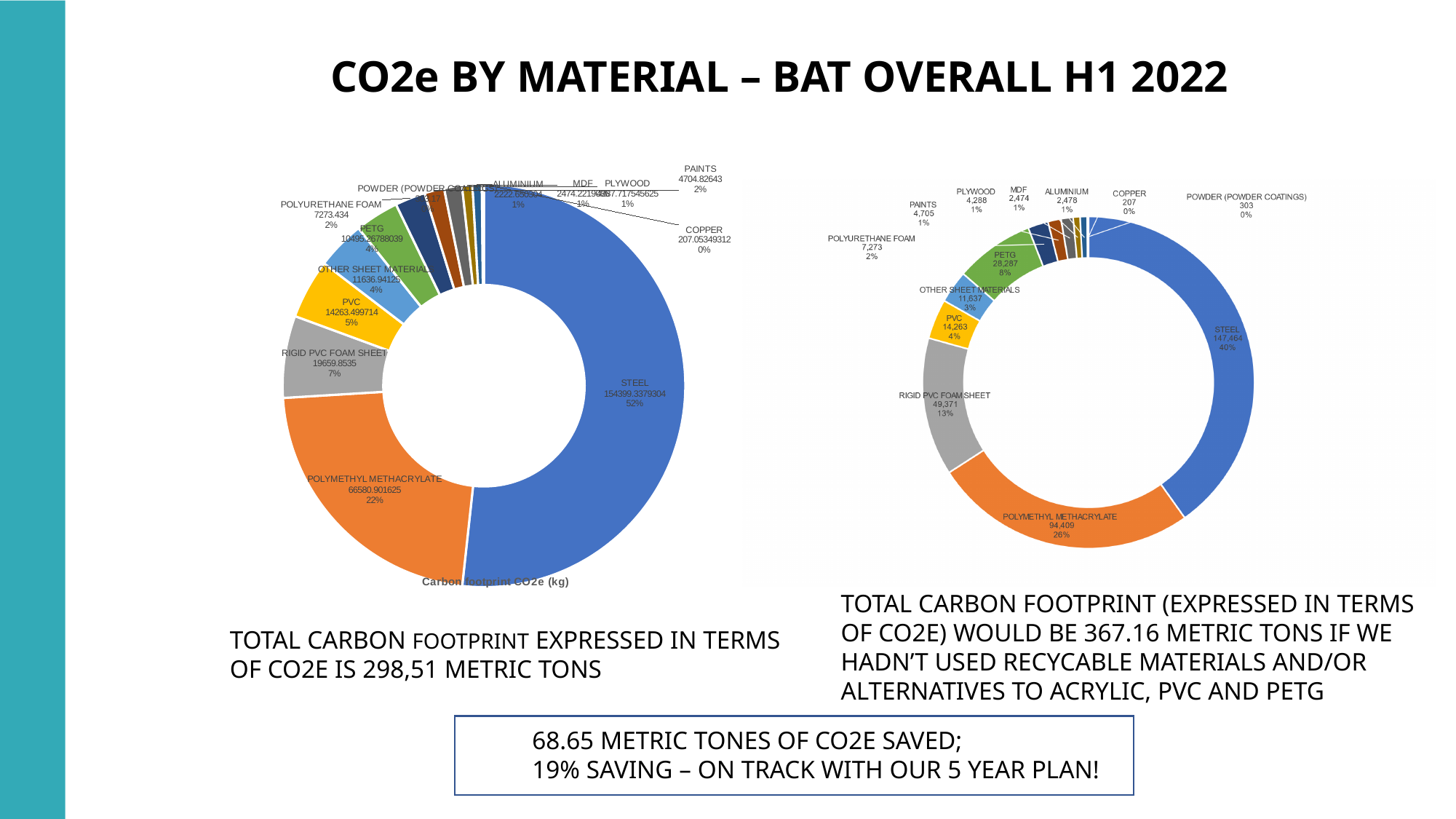
In the right-hand doughnut chart, what is the difference between the values for PETG and PVC? 14,024 In the right-hand doughnut chart, which material has the smallest value? COPPER What type of chart is shown on the left side of the slide? Doughnut (pie) chart What is the title of the slide? CO2e BY MATERIAL – BAT OVERALL H1 2022 In the right-hand doughnut chart, which material has the largest value? STEEL In the right-hand doughnut chart, what share of the total does POLYMETHYL METHACRYLATE represent? 26% How many material categories are shown in the right-hand doughnut chart? 13 In the right-hand doughnut chart, what is the value for STEEL? 147,464 In the right-hand doughnut chart, which is larger: the value for PLYWOOD or the value for MDF? PLYWOOD In the left-hand doughnut chart, what percentage share does RIGID PVC FOAM SHEET have? 7% In the right-hand doughnut chart, what is the value for RIGID PVC FOAM SHEET? 49,371 In the left-hand doughnut chart, what percentage share does STEEL have? 52%